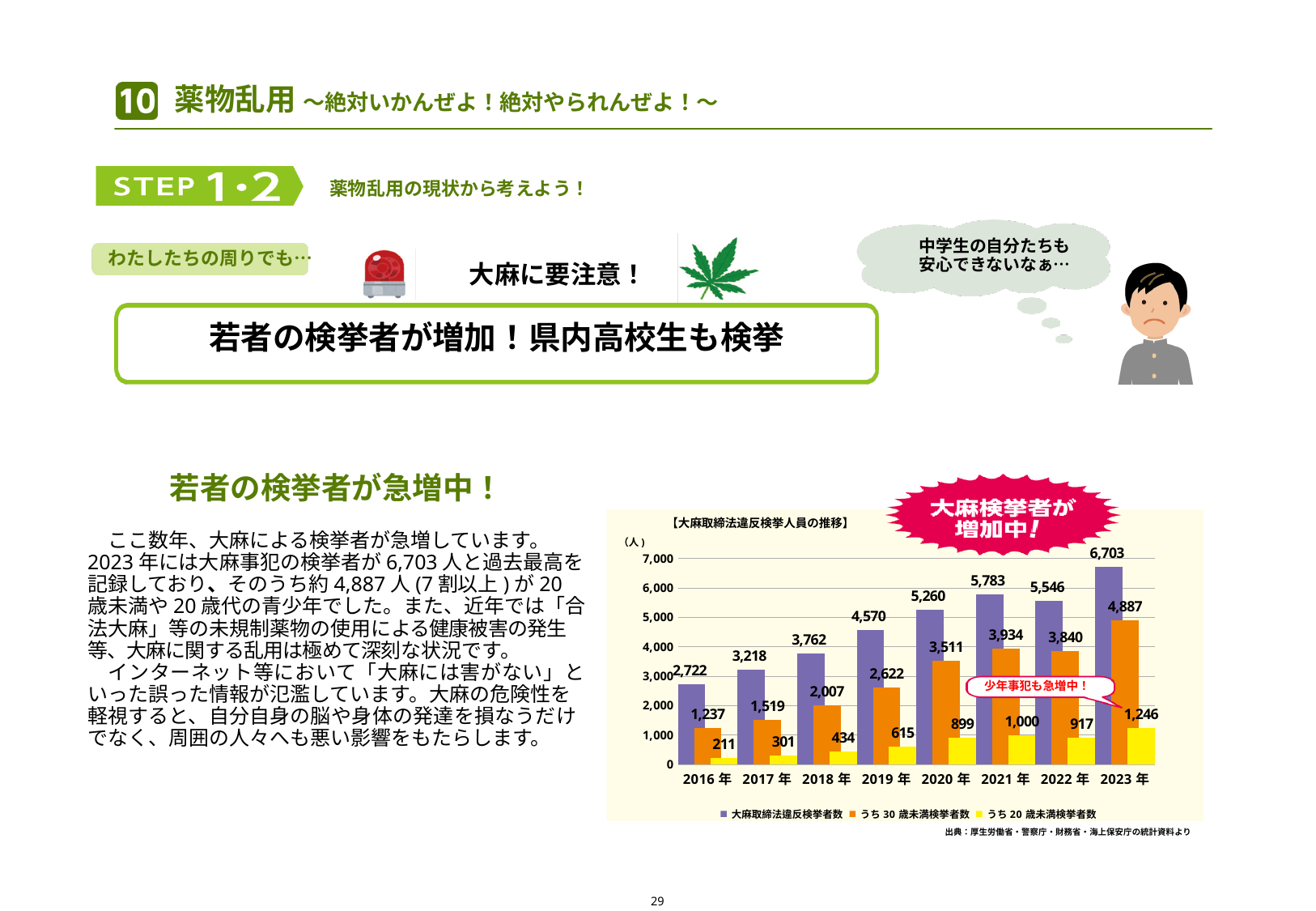
グラフ「大麻取締法違反検挙人員の推移」で、大麻取締法違反検挙者数が最も多い年はどれですか？ 2023年 グラフ「大麻取締法違反検挙人員の推移」の凡例には系列がいくつありますか？ 3 グラフ「大麻取締法違反検挙人員の推移」で、2023年と2022年の大麻取締法違反検挙者数の差はいくつですか？ 1,157 グラフ「大麻取締法違反検挙人員の推移」で、うち30歳未満検挙者数は2016年から2021年にかけて増加していますか、減少していますか？ 増加 グラフ「大麻取締法違反検挙人員の推移」で、うち20歳未満検挙者数が最も少ない年はどれですか？ 2016年 グラフ「大麻取締法違反検挙人員の推移」で、2020年の大麻取締法違反検挙者数は5,000より多いですか、少ないですか？ 多い グラフ「大麻取締法違反検挙人員の推移」で、2019年のうち30歳未満検挙者数はいくつですか？ 2,622 グラフ「大麻取締法違反検挙人員の推移」はどの種類のグラフですか？ 棒グラフ グラフ「大麻取締法違反検挙人員の推移」で、2023年の大麻取締法違反検挙者数はいくつですか？ 6,703 グラフ「大麻取締法違反検挙人員の推移」には何年分のデータがありますか？ 8 グラフ「大麻取締法違反検挙人員の推移」で、2021年のうち20歳未満検挙者数はいくつですか？ 1,000 グラフ「大麻取締法違反検挙人員の推移」で、2021年と2022年の大麻取締法違反検挙者数はどちらが多いですか？ 2021年